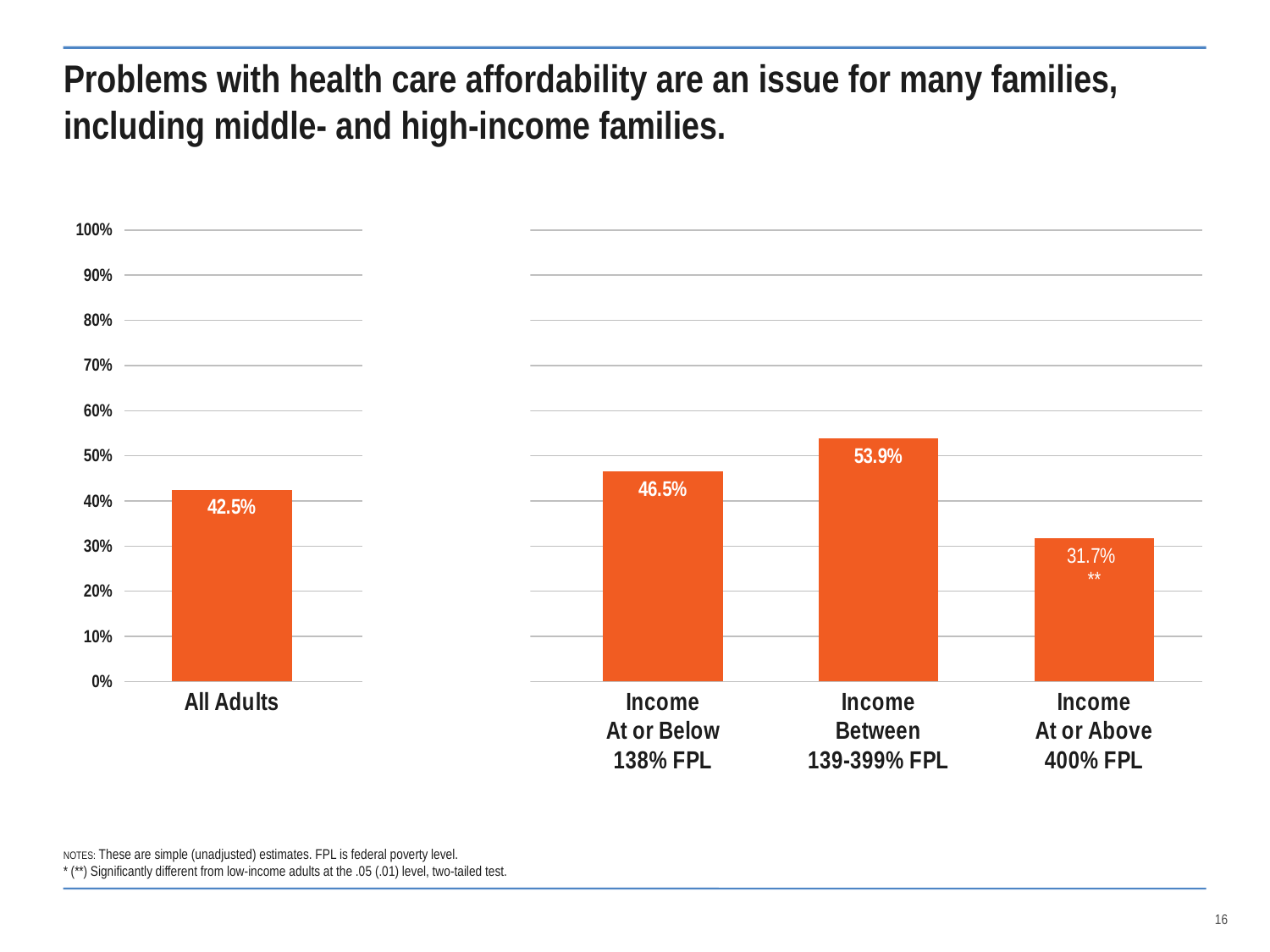
On the left chart, what is the value for All Adults? 42.5% On the right chart, which income group has the lowest value? Income At or Above 400% FPL On the right chart, what is the difference between the values for Income Between 139-399% FPL and Income At or Above 400% FPL? 22.2% What kind of chart is the right chart? bar chart How many categories are shown on the right chart? 3 On the right chart, what is the value for Income At or Below 138% FPL? 46.5% On the right chart, which income group has the highest value? Income Between 139-399% FPL On the right chart, what is the difference between the values for Income At or Below 138% FPL and Income At or Above 400% FPL? 14.8% On the right chart, what is the value for Income At or Above 400% FPL? 31.7% On the right chart, what is the value for Income Between 139-399% FPL? 53.9% Which is larger: the value for All Adults on the left chart or the value for Income At or Below 138% FPL on the right chart? Income At or Below 138% FPL On the right chart, is the value for Income Between 139-399% FPL greater or less than 50%? greater